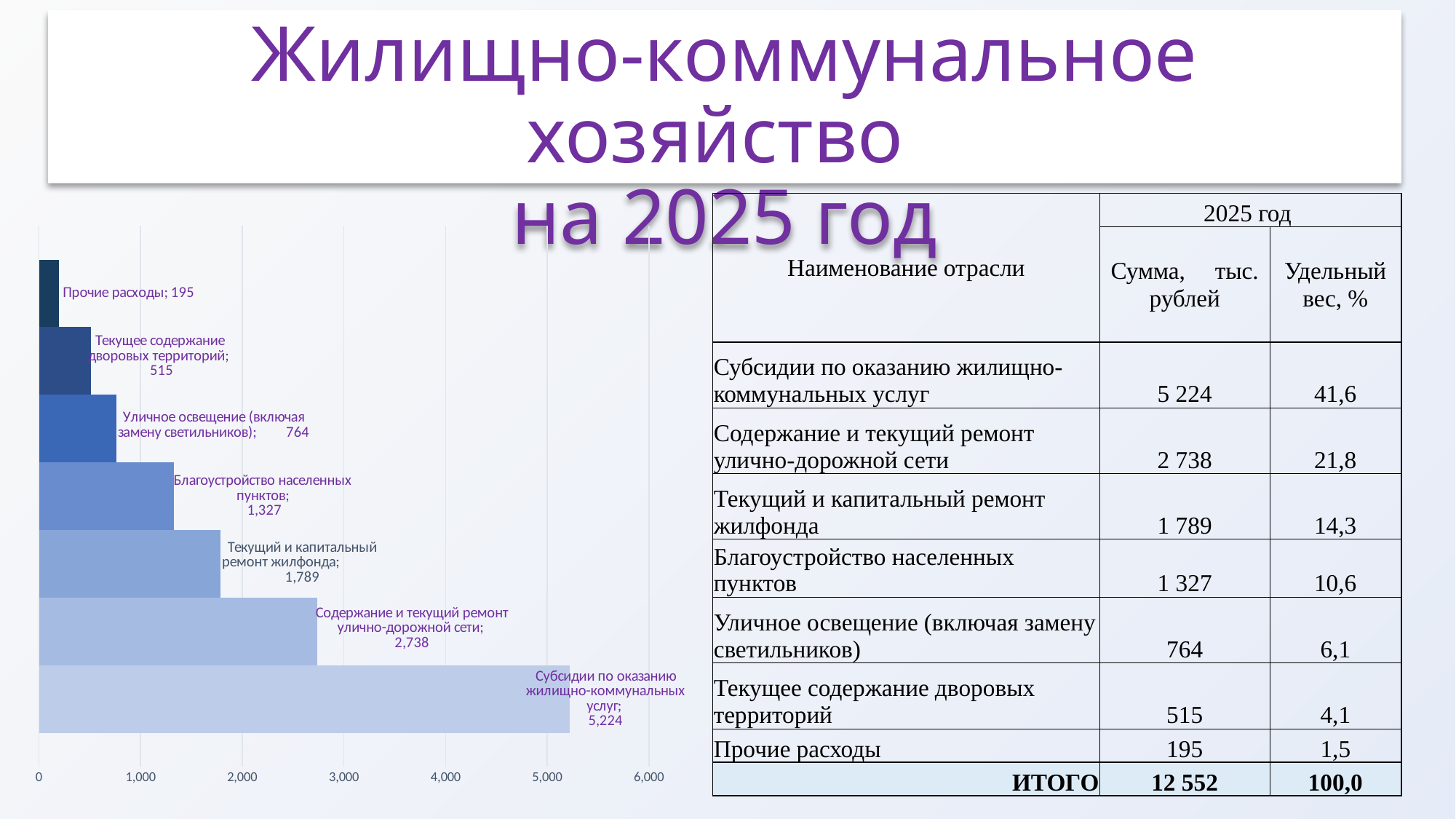
How many categories are plotted in the bar chart? 7 What is the difference between «Содержание и текущий ремонт улично-дорожной сети» and «Текущий и капитальный ремонт жилфонда» in the bar chart? 949 Which category has the lowest value in the bar chart? Прочие расходы Is the value for «Содержание и текущий ремонт улично-дорожной сети» greater or less than 3,000? less Which category has the highest value in the bar chart? Субсидии по оказанию жилищно-коммунальных услуг What is the value for «Прочие расходы» in the bar chart? 195 Which is larger in the bar chart: «Текущее содержание дворовых территорий» or «Уличное освещение (включая замену светильников)»? Уличное освещение (включая замену светильников) What is the value for «Благоустройство населенных пунктов» in the bar chart? 1,327 What is the highest tick value shown on the horizontal axis of the bar chart? 6,000 What is the value for «Уличное освещение (включая замену светильников)» in the bar chart? 764 What is the value for «Субсидии по оказанию жилищно-коммунальных услуг» in the bar chart? 5,224 What type of chart is shown on the left of the slide? bar chart